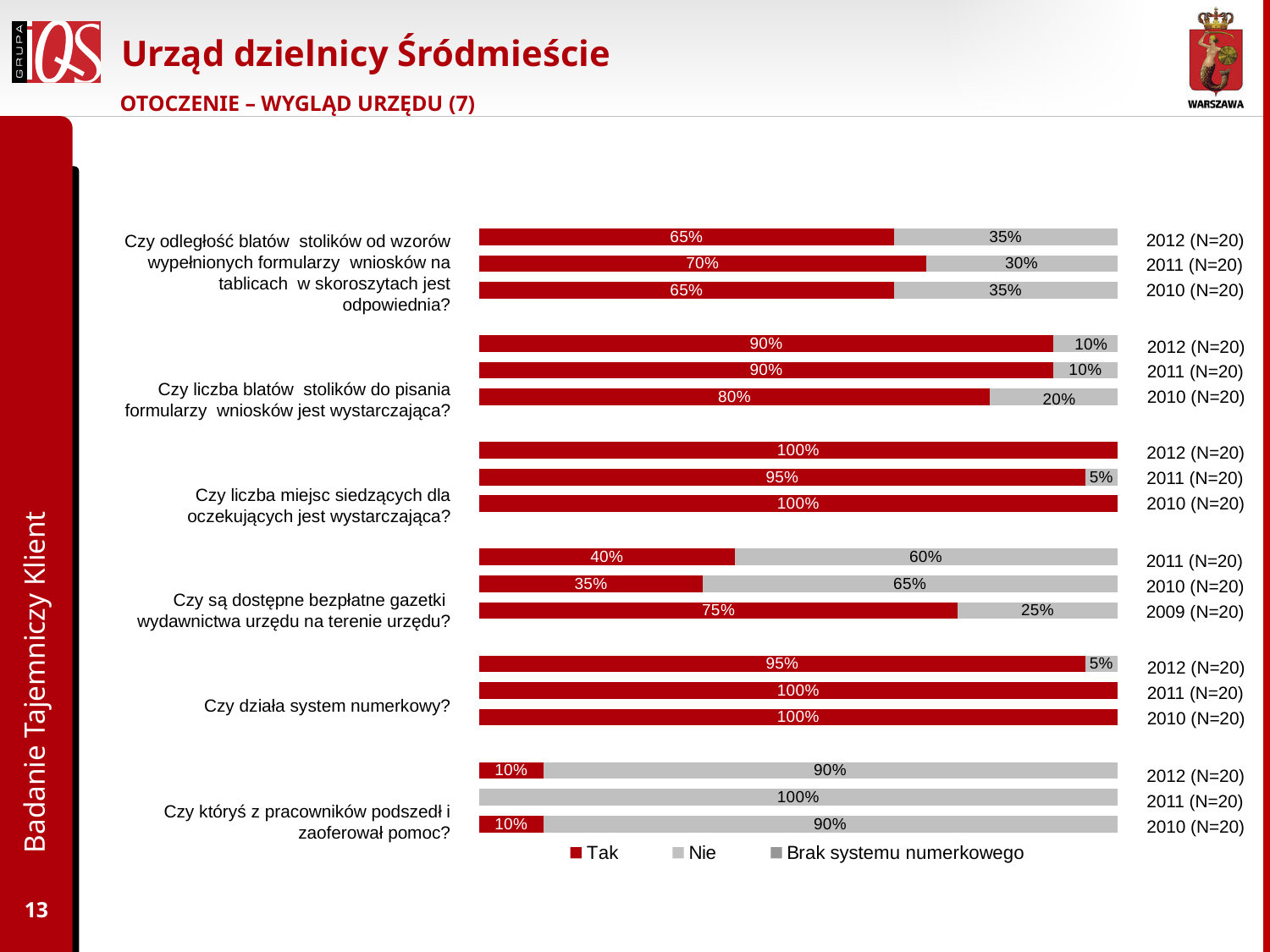
What percentage answered "Tak" in 2009 for "Czy są dostępne bezpłatne gazetki wydawnictwa urzędu na terenie urzędu?"? 75% For "Czy są dostępne bezpłatne gazetki wydawnictwa urzędu na terenie urzędu?", which year has the highest "Tak" share? 2009 For "Czy odległość blatów stolików od wzorów wypełnionych formularzy wniosków na tablicach w skoroszytach jest odpowiednia?", is the "Tak" share larger in 2011 or in 2012? 2011 What kind of chart is shown on the slide? Stacked bar chart What percentage answered "Nie" in 2011 for "Czy któryś z pracowników podszedł i zaoferował pomoc?"? 100% For "Czy liczba blatów stolików do pisania formularzy wniosków jest wystarczająca?", which year has the lowest "Tak" share? 2010 What percentage answered "Tak" in 2011 for "Czy liczba miejsc siedzących dla oczekujących jest wystarczająca?"? 95% What percentage answered "Tak" in 2011 for "Czy odległość blatów stolików od wzorów wypełnionych formularzy wniosków na tablicach w skoroszytach jest odpowiednia?"? 70% What is the difference between the "Tak" share in 2009 and in 2010 for "Czy są dostępne bezpłatne gazetki wydawnictwa urzędu na terenie urzędu?"? 40% What percentage answered "Nie" in 2010 for "Czy liczba blatów stolików do pisania formularzy wniosków jest wystarczająca?"? 20% What percentage answered "Tak" in 2012 for "Czy działa system numerkowy?"? 95% How many series does the legend list? 3